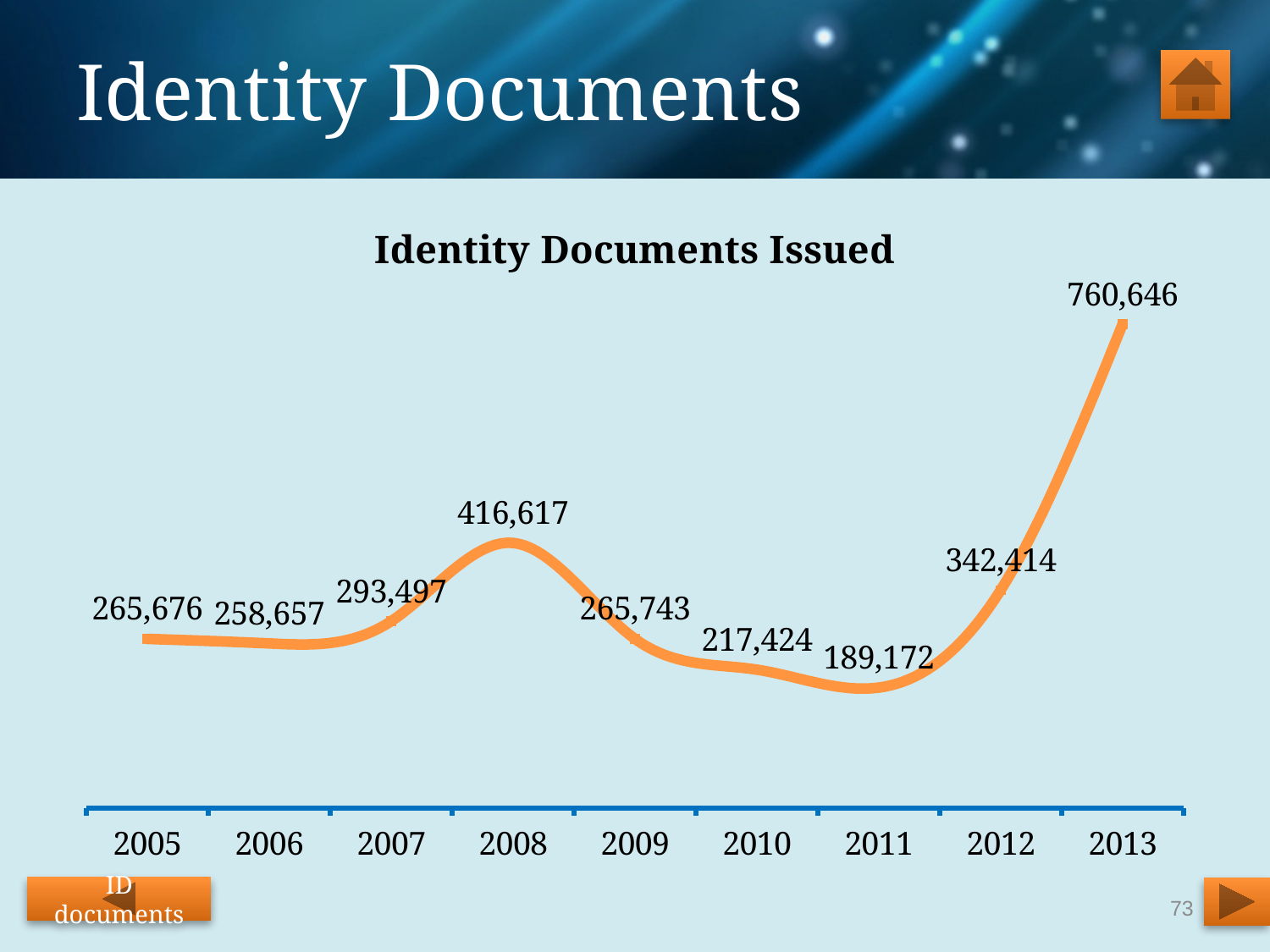
Which year has the lowest number of identity documents issued? 2011 How many years are plotted on the x axis? 9 Do the values rise or fall from 2011 to 2013? rise What is the difference between the values for 2008 and 2007? 123,120 What is the value for 2013? 760,646 Which is larger, the value for 2005 or the value for 2009? 2009 What is the difference between the values for 2013 and 2012? 418,232 What is the value for 2011? 189,172 How many identity documents were issued in 2008? 416,617 What is the title of the chart? Identity Documents Issued Which year has the highest number of identity documents issued? 2013 What kind of chart is shown on the slide? line chart